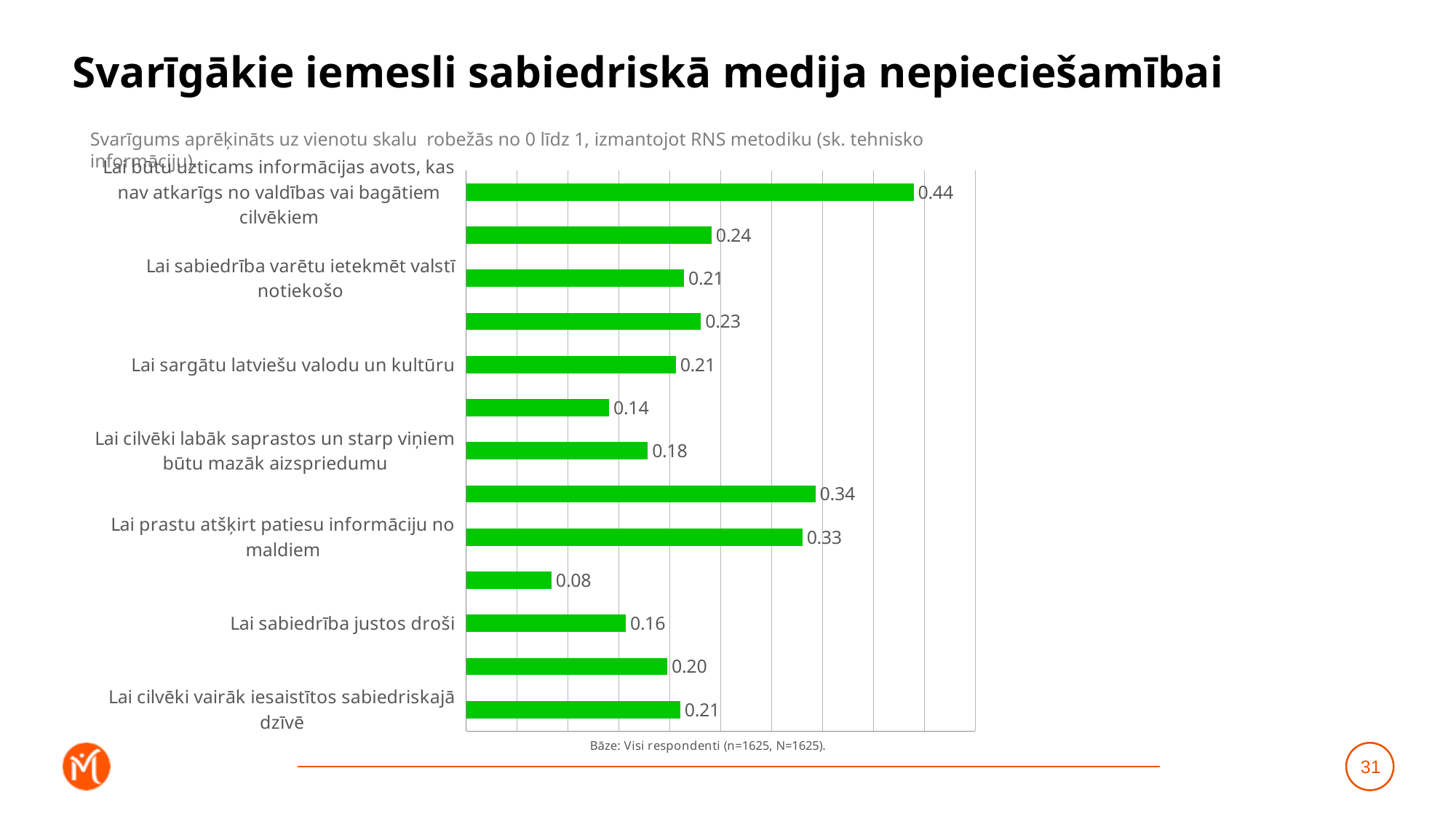
Which labelled category has the highest value in the chart? Lai būtu uzticams informācijas avots, kas nav atkarīgs no valdības vai bagātiem cilvēkiem What is the value for "Lai būtu uzticams informācijas avots, kas nav atkarīgs no valdības vai bagātiem cilvēkiem"? 0.44 How many bars are plotted in the chart? 13 Which has a larger value: "Lai sabiedrība justos droši" or "Lai cilvēki vairāk iesaistītos sabiedriskajā dzīvē"? Lai cilvēki vairāk iesaistītos sabiedriskajā dzīvē What is the value for "Lai sargātu latviešu valodu un kultūru"? 0.21 What is the value for "Lai prastu atšķirt patiesu informāciju no maldiem"? 0.33 What type of chart is shown on the slide? bar chart What is the lowest value shown on any bar in the chart? 0.08 What is the difference between the values for "Lai būtu uzticams informācijas avots, kas nav atkarīgs no valdības vai bagātiem cilvēkiem" and "Lai prastu atšķirt patiesu informāciju no maldiem"? 0.11 What is the value for "Lai sabiedrība justos droši"? 0.16 What is the title of the slide? Svarīgākie iemesli sabiedriskā medija nepieciešamībai What is the value for "Lai cilvēki labāk saprastos un starp viņiem būtu mazāk aizspriedumu"? 0.18